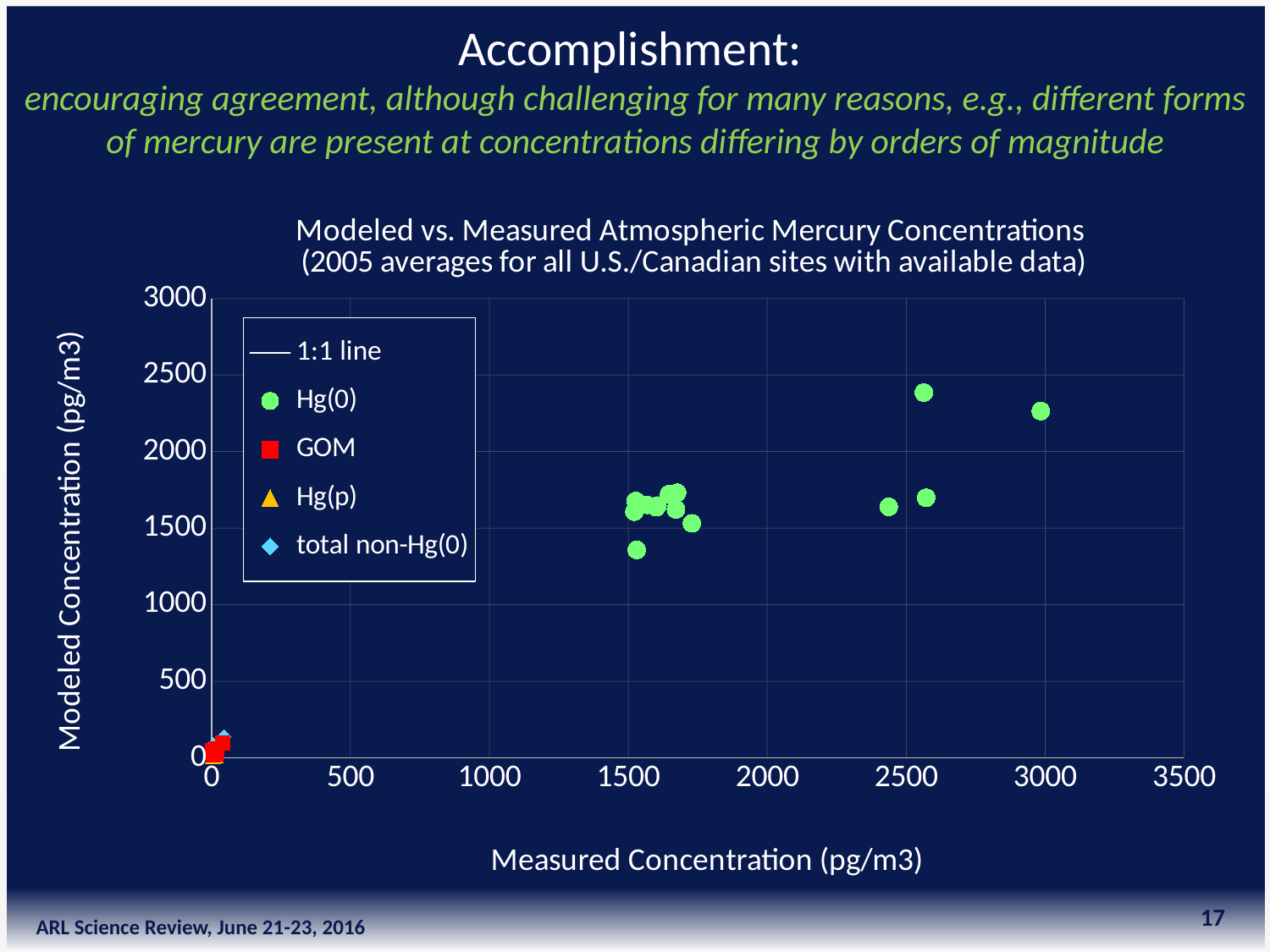
What is the label of the x axis? Measured Concentration (pg/m3) Which series has the lowest measured concentrations on the chart, Hg(0) or GOM? GOM Is the measured concentration of the Hg(0) point with the highest measured value greater or less than 2500? greater Which series has the higher modeled concentrations, Hg(0) or GOM? Hg(0) What kind of chart is shown on the slide? scatter chart Is the lowest modeled concentration among the Hg(0) points greater or less than 1500? less How many entries does the chart legend list? 5 What is the title of the chart? Modeled vs. Measured Atmospheric Mercury Concentrations (2005 averages for all U.S./Canadian sites with available data) Is the modeled concentration of the Hg(0) point with the highest measured concentration greater or less than 2000? greater